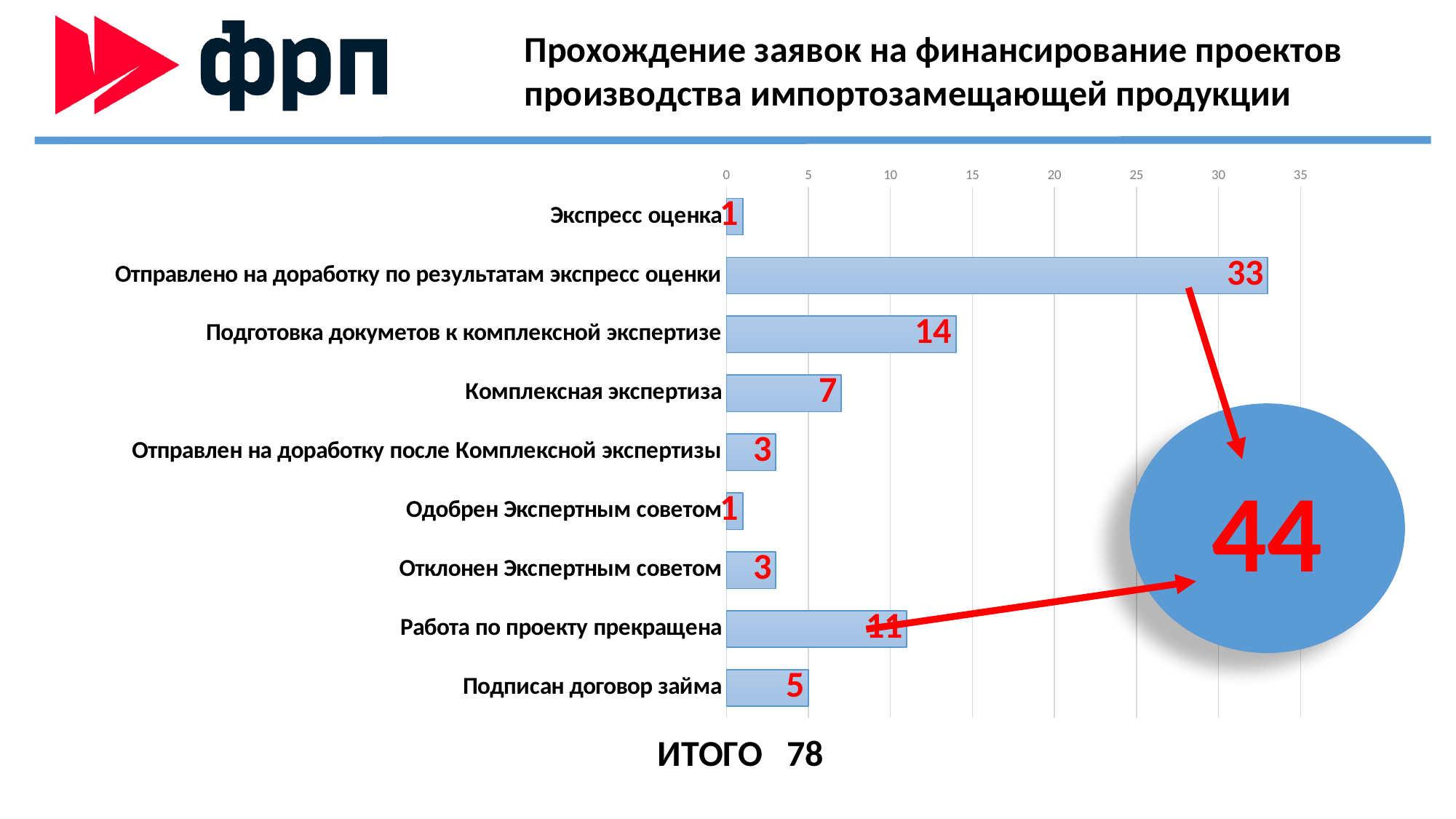
What is the difference between the values for "Отправлено на доработку по результатам экспресс оценки" and "Подготовка докуметов к комплексной экспертизе"? 19 What is the difference between the values for "Комплексная экспертиза" and "Подписан договор займа"? 2 What number is shown in the large blue circle to the right of the chart? 44 What is the value for "Отправлено на доработку по результатам экспресс оценки"? 33 What is the value for "Работа по проекту прекращена"? 11 Which is larger: the value for "Комплексная экспертиза" or the value for "Работа по проекту прекращена"? Работа по проекту прекращена What total (ИТОГО) is printed below the chart? 78 What type of chart is shown on the slide? bar chart Which category has the highest value? Отправлено на доработку по результатам экспресс оценки What is the value for "Подписан договор займа"? 5 How many categories does the bar chart show? 9 What is the value for "Подготовка докуметов к комплексной экспертизе"? 14